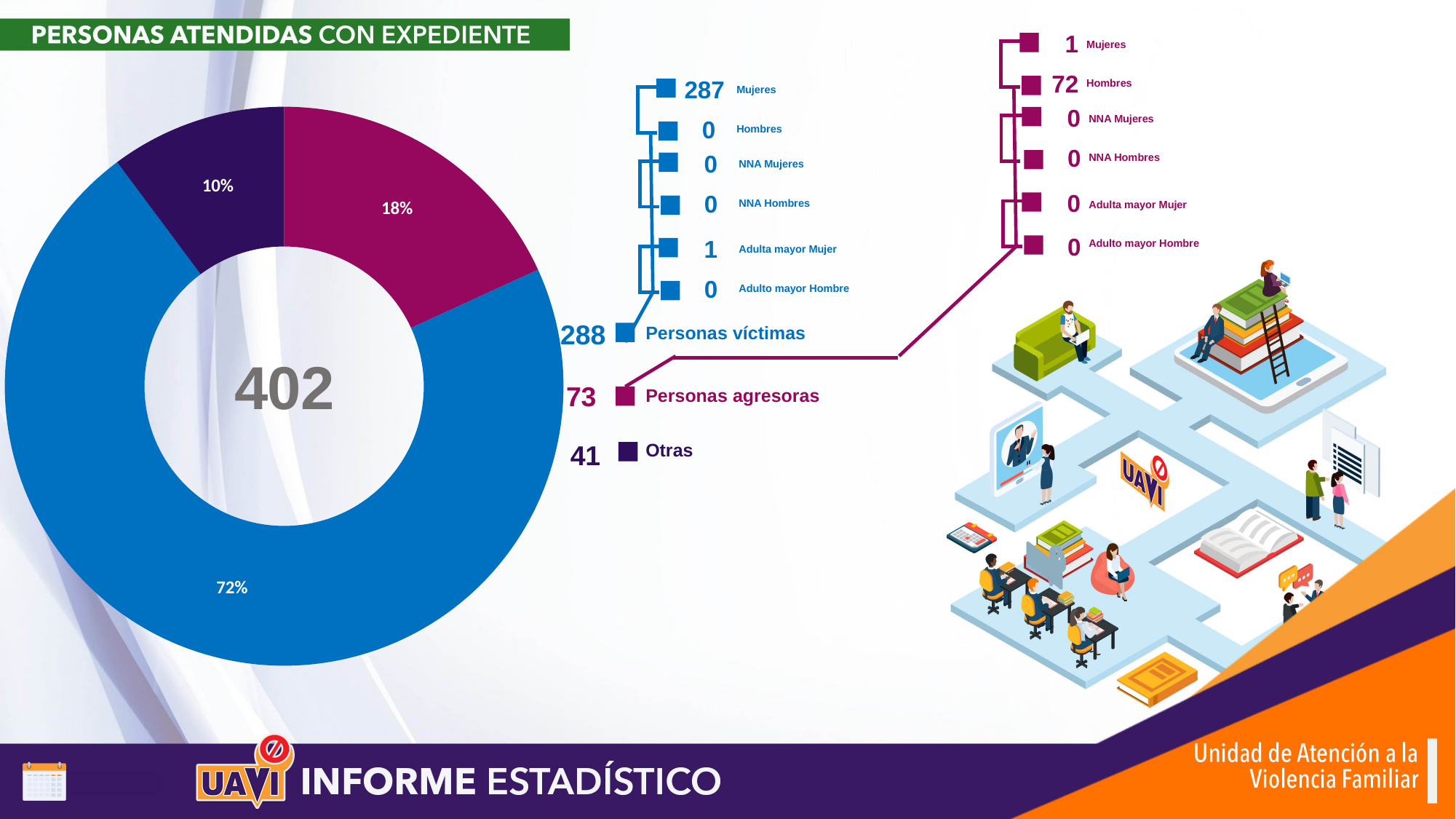
What percentage of the donut chart corresponds to Personas víctimas? 72% What percentage of the donut chart corresponds to Personas agresoras? 18% What is the difference in count between Personas agresoras and Otras? 32 What number is shown in the centre of the donut chart? 402 What percentage of the donut chart corresponds to Otras? 10% How many people are counted as Personas víctimas? 288 What kind of chart is shown on the slide? Donut (pie) chart How many people are counted as Personas agresoras? 73 Which category has the smallest share of the donut chart? Otras Which is larger, the share for Personas agresoras or the share for Otras? Personas agresoras How many categories does the donut chart have? 3 Which category has the largest share of the donut chart? Personas víctimas